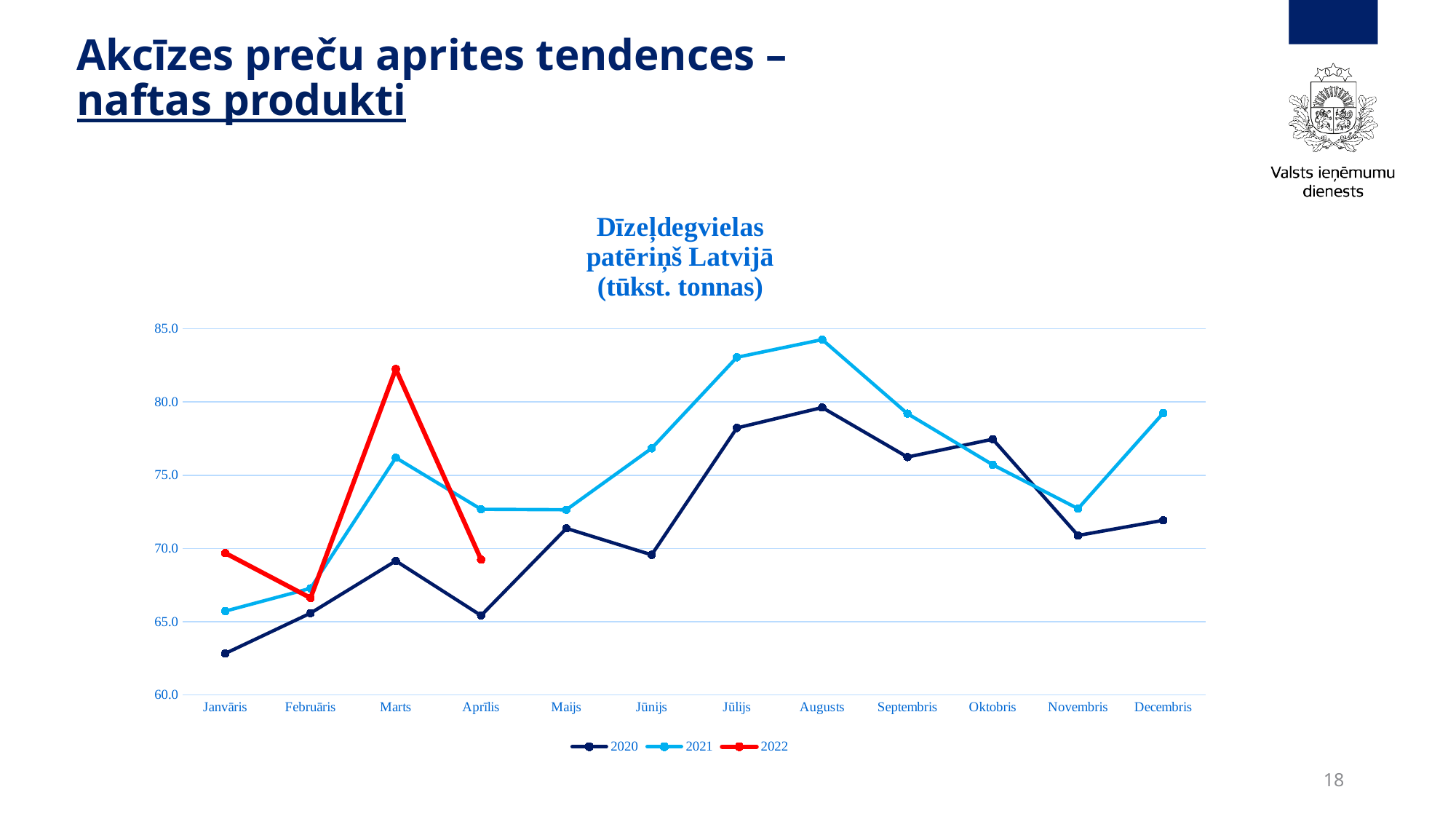
What kind of chart is shown on the slide? line chart In Marts, which series has the higher value, 2021 or 2022? 2022 In which month does the 2022 series reach its highest value? Marts Does the 2020 series rise or fall from Janvāris to Marts? rise What unit is given in the chart title? tūkst. tonnas Is the value for 2020 in Janvāris greater or less than 65.0? less In which month does the 2021 series reach its highest value? Augusts How many months are shown on the x axis? 12 In which month does the 2020 series have its lowest value? Janvāris Is the value for 2021 in Jūlijs greater or less than 80.0? greater How many series does the legend list? 3 How many data points does the 2022 series have? 4